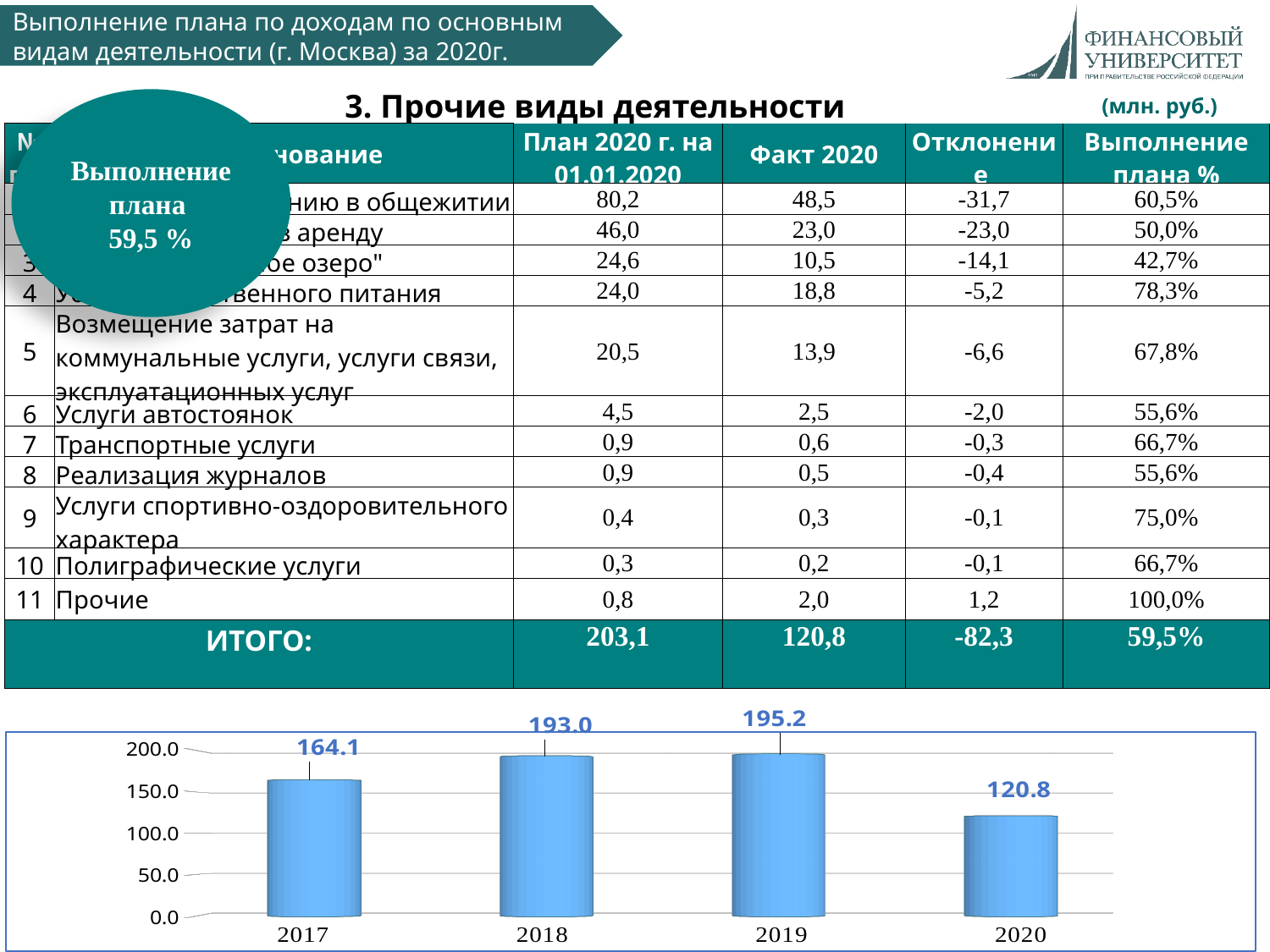
What type of chart is shown at the bottom of the slide? bar chart What is the difference between the values for 2019 and 2020 in the bar chart? 74.4 What is the value shown for 2019 in the bar chart? 195.2 Which year has the highest value in the bar chart? 2019 Which is larger in the bar chart, the value for 2017 or the value for 2020? 2017 How many years are shown on the x axis of the bar chart? 4 What is the value shown for 2020 in the bar chart? 120.8 What is the value shown for 2018 in the bar chart? 193.0 Is the value for 2020 in the bar chart greater or less than 150.0? less What is the value shown for 2017 in the bar chart? 164.1 What is the difference between the values for 2018 and 2017 in the bar chart? 28.9 Which year has the lowest value in the bar chart? 2020